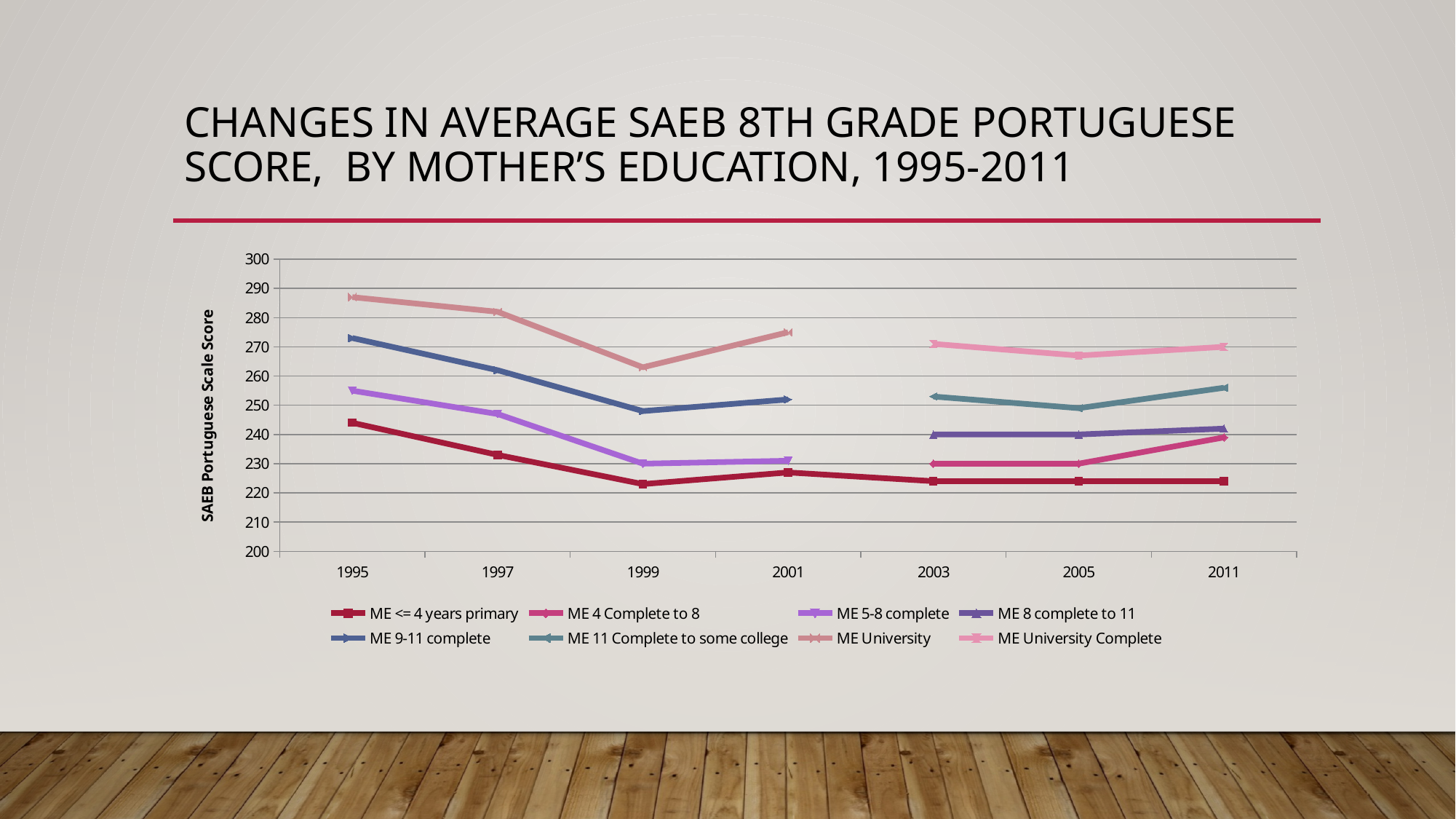
Is the value for ME 8 complete to 11 in 2003 greater or less than 250? less How many series does the legend list? 8 What is the label of the vertical axis? SAEB Portuguese Scale Score Is the value for ME University in 1995 greater or less than 280? greater Is the value for ME 5-8 complete in 1999 greater or less than 240? less Which series has the highest score in 1995? ME University Does the ME <= 4 years primary line rise or fall from 1995 to 1999? Fall How many years are shown on the x axis? 7 What kind of chart is shown on the slide? Line chart In 1999, which is larger: ME <= 4 years primary or ME 5-8 complete? ME 5-8 complete Which series has the lowest score in 2011? ME <= 4 years primary